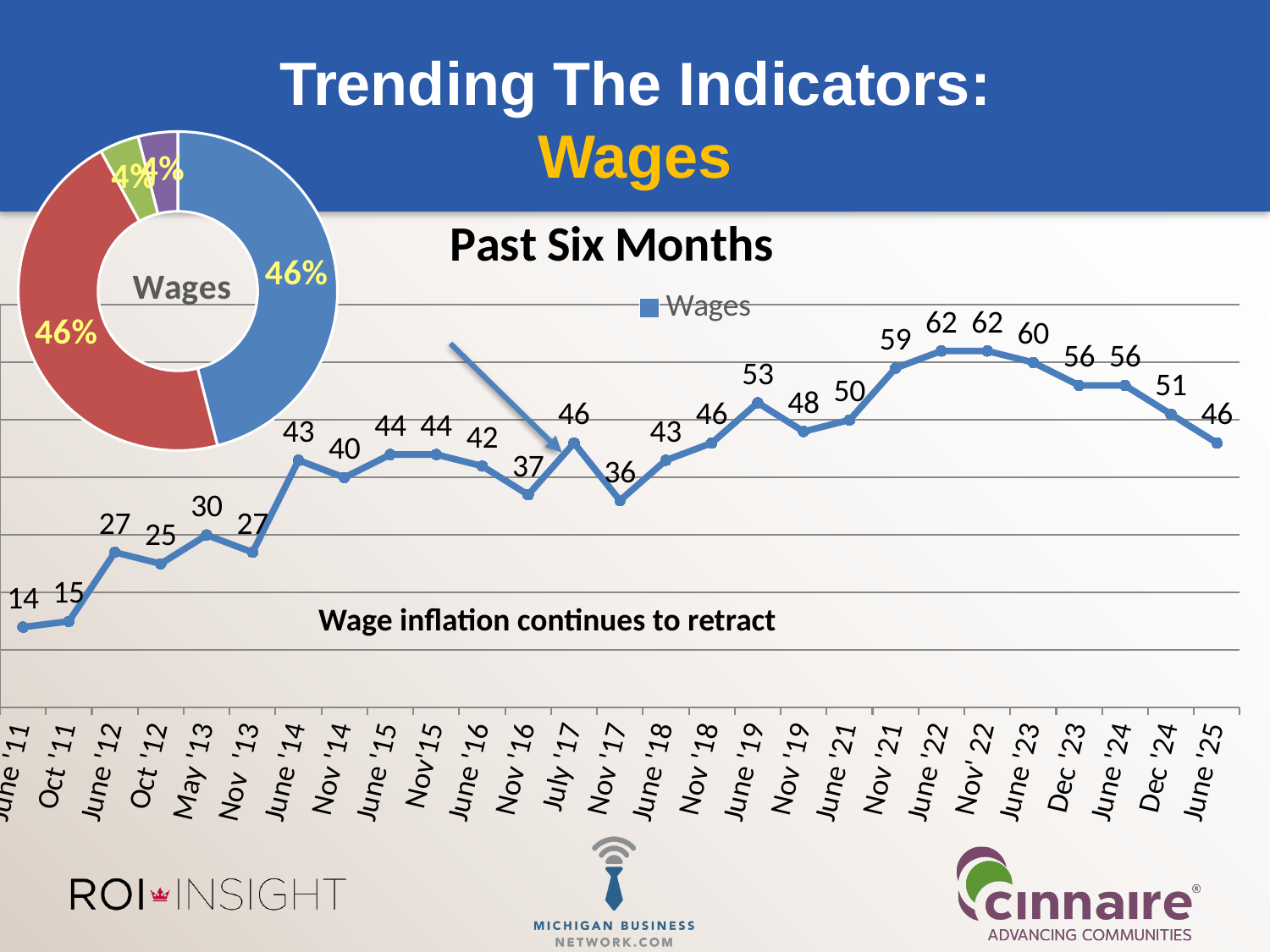
In the line chart titled "Past Six Months", what is the difference between the values for June '22 and June '11? 48 In the line chart titled "Past Six Months", which is larger, the value for June '19 or the value for Nov '19? June '19 In the line chart titled "Past Six Months", what is the difference between the values for Dec '24 and June '25? 5 In the line chart titled "Past Six Months", do the values rise or fall from June '22 to June '25? fall In the line chart titled "Past Six Months", what is the value for June '25? 46 In the line chart titled "Past Six Months", how many data points are plotted? 27 How many slices does the doughnut chart in the top-left corner of the slide have? 4 In the line chart titled "Past Six Months", what is the value for June '11? 14 In the line chart titled "Past Six Months", what is the highest value plotted? 62 What kind of chart is the chart in the top-left corner of the slide? doughnut chart In the line chart titled "Past Six Months", what is the value for Nov '21? 59 In the line chart titled "Past Six Months", which point has the lowest value? June '11